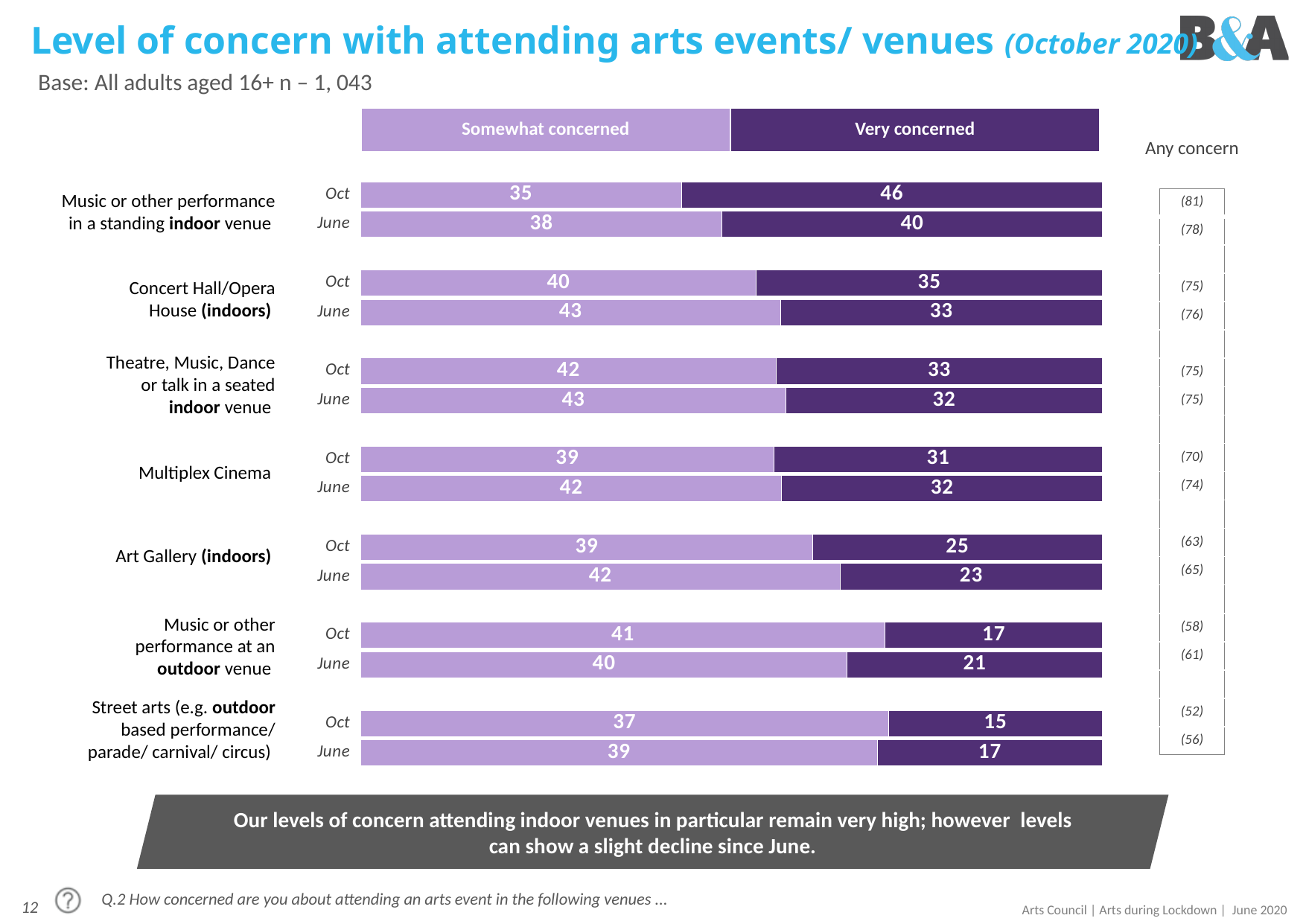
In Oct, which has the larger 'Very concerned' value: Multiplex Cinema or Art Gallery (indoors)? Multiplex Cinema What is the 'Somewhat concerned' value for Concert Hall/Opera House (indoors) in June? 43 What is the 'Any concern' figure shown for Art Gallery (indoors) in Oct? (63) How many venue categories are shown in the chart? 7 Which venue has the lowest 'Very concerned' value in Oct? Street arts (e.g. outdoor based performance/ parade/ carnival/ circus) What is the 'Very concerned' value for Music or other performance in a standing indoor venue in Oct? 46 By how much did the 'Very concerned' value for Music or other performance in a standing indoor venue change from June to Oct? 6 What is the total of the Oct stacked bar for Multiplex Cinema (Somewhat concerned plus Very concerned)? 70 How many series does the legend list? 2 What kind of chart is shown on the slide? Stacked bar chart Which colour represents the 'Very concerned' series in the chart? Dark purple Which venue has the highest 'Very concerned' value in Oct? Music or other performance in a standing indoor venue